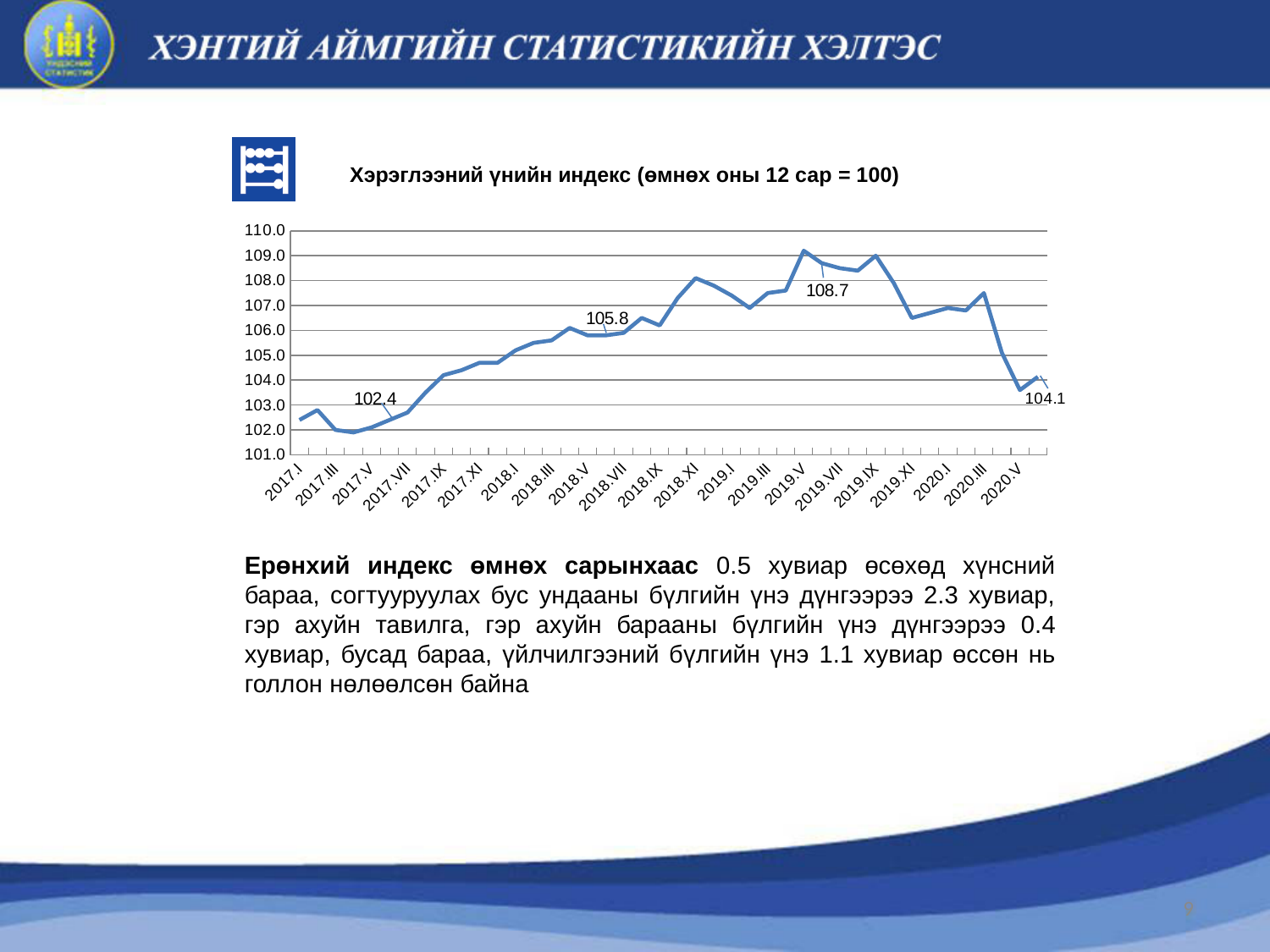
Is the value for 2017.III greater or less than 103.0? less Which labeled value is larger, 105.8 or 104.1? 105.8 Does the index rise or fall between 2019.IX and 2020.V? fall What is the difference between the labeled values 105.8 and 102.4? 3.4 What value is labeled at the final (most recent) point of the line? 104.1 What is the highest value printed as a data label on the chart? 108.7 What is the title of the chart? Хэрэглээний үнийн индекс (өмнөх оны 12 сар = 100) What is the difference between the labeled values 108.7 and 102.4? 6.3 What kind of chart is shown on the slide? line chart What is the lowest value printed as a data label on the chart? 102.4 Is the value for 2019.V greater or less than 108.0? greater How many data labels are printed on the line? 4